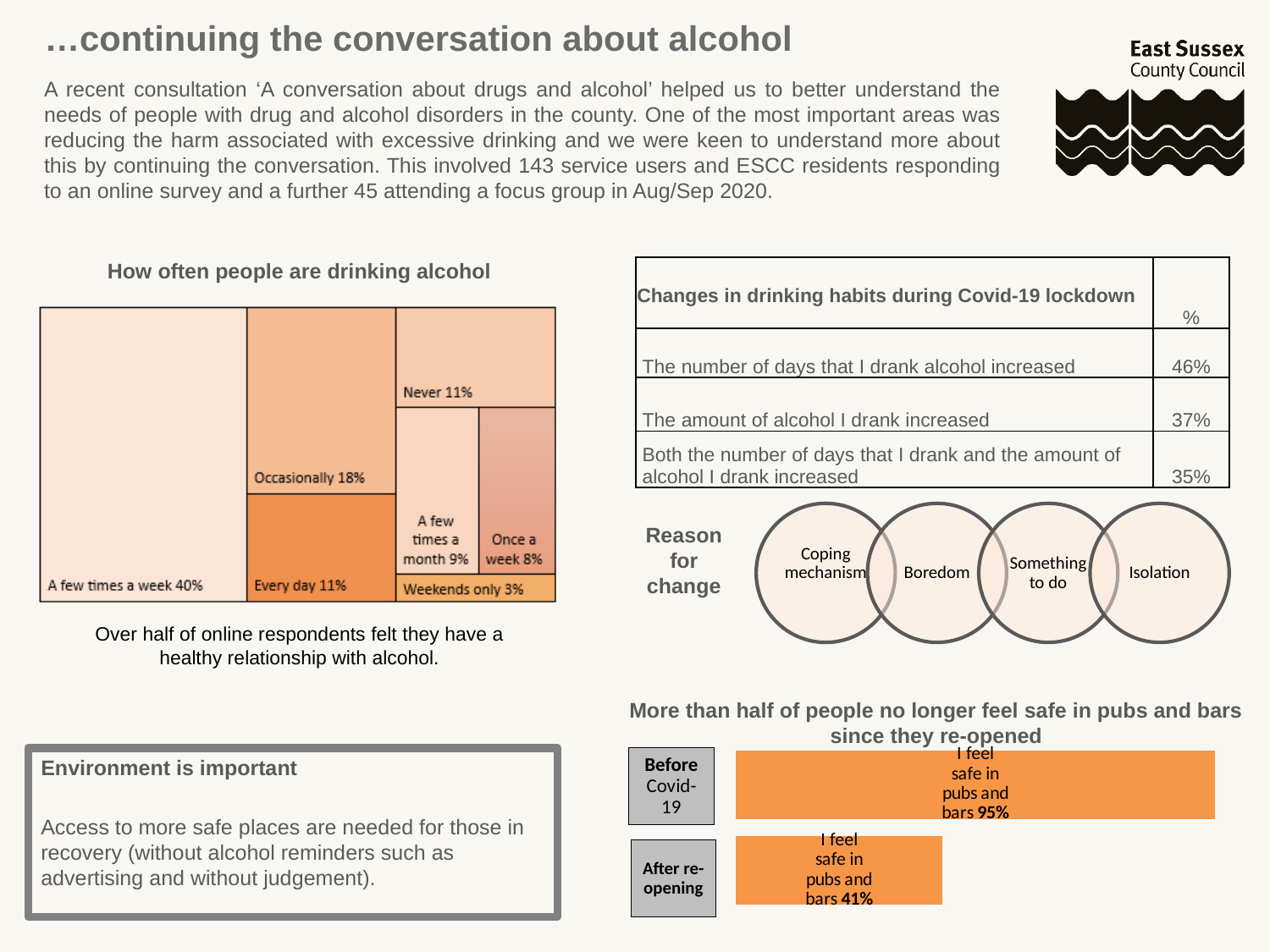
How many categories are shown in the 'How often people are drinking alcohol' chart? 7 In the 'How often people are drinking alcohol' chart, which category has the lowest percentage? Weekends only In the chart about feeling safe in pubs and bars, what percentage felt safe before Covid-19? 95% In the 'How often people are drinking alcohol' chart, what percentage of people drink occasionally? 18% What kind of chart is 'How often people are drinking alcohol'? Treemap In the 'How often people are drinking alcohol' chart, what is the difference between the percentage for 'A few times a week' and 'Occasionally'? 22% In the 'How often people are drinking alcohol' chart, what percentage of people drink on weekends only? 3% In the 'How often people are drinking alcohol' chart, which category has the highest percentage? A few times a week In the 'How often people are drinking alcohol' chart, which is larger: 'A few times a month' or 'Once a week'? A few times a month In the chart about feeling safe in pubs and bars, what percentage felt safe after re-opening? 41% In the chart about feeling safe in pubs and bars, what is the difference between the before Covid-19 and after re-opening percentages? 54% In the 'How often people are drinking alcohol' chart, what percentage of people drink a few times a week? 40%